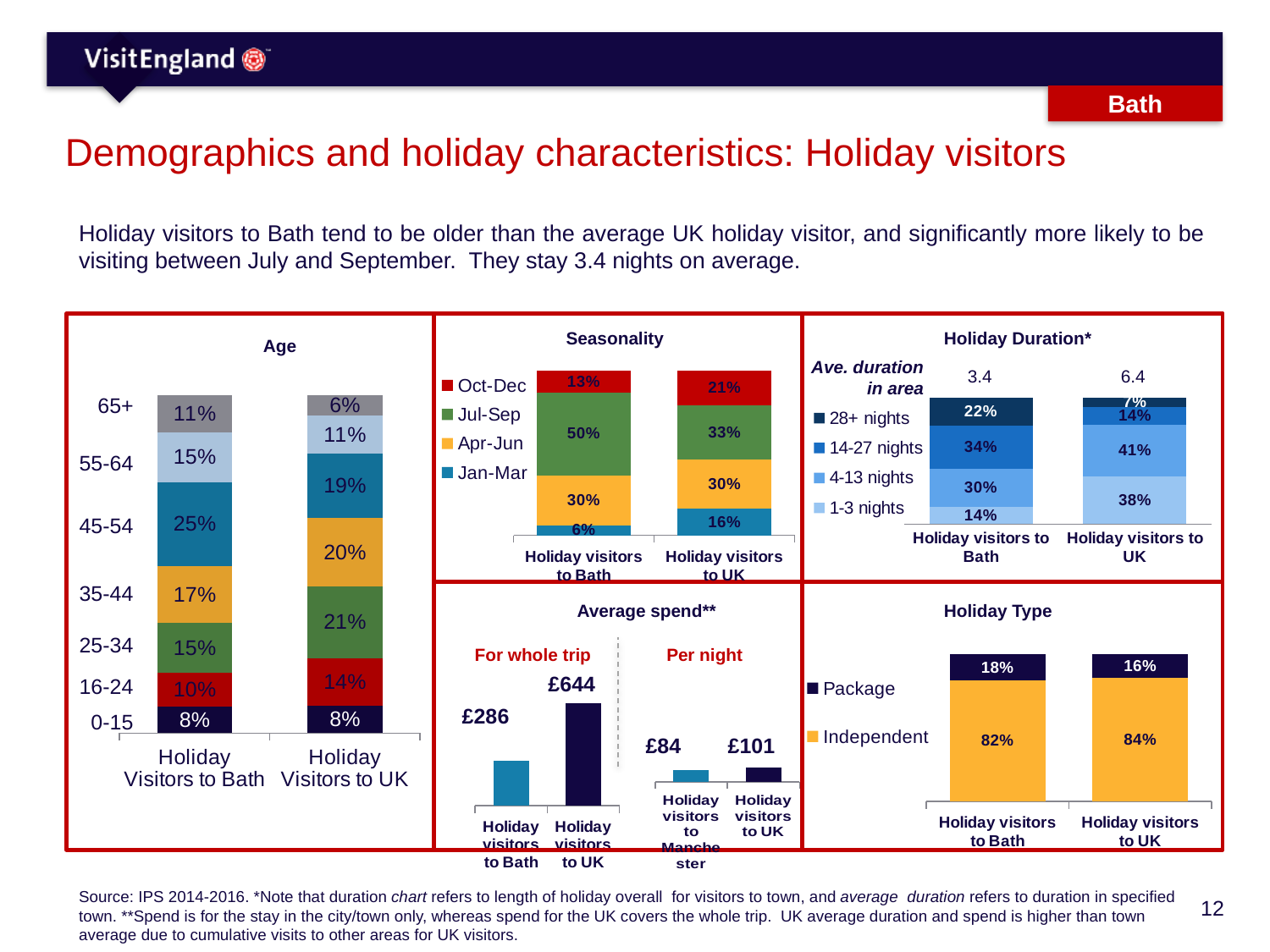
In the Holiday Duration chart, what percentage of Holiday visitors to Bath stay 14-27 nights? 34% In the Seasonality chart, what share of Holiday visitors to Bath visit in Jul-Sep? 50% In the Holiday Duration chart, what is the average duration in area for Holiday visitors to UK? 6.4 In the Age chart, what percentage of Holiday Visitors to Bath are aged 45-54? 25% In the Age chart, what percentage of Holiday Visitors to UK are aged 65+? 6% In the Age chart, which age group is the largest for Holiday Visitors to Bath? 45-54 In the Seasonality chart, what is the difference between the Jul-Sep share for Holiday visitors to Bath and for Holiday visitors to UK? 17% In the Holiday Type chart, what percentage of Holiday visitors to Bath are on a Package holiday? 18% In the Seasonality chart, how many series does the legend list? 4 In the Average spend chart, what is the spend for the whole trip for Holiday visitors to UK? £644 What type of chart is the Holiday Type chart? Stacked bar chart